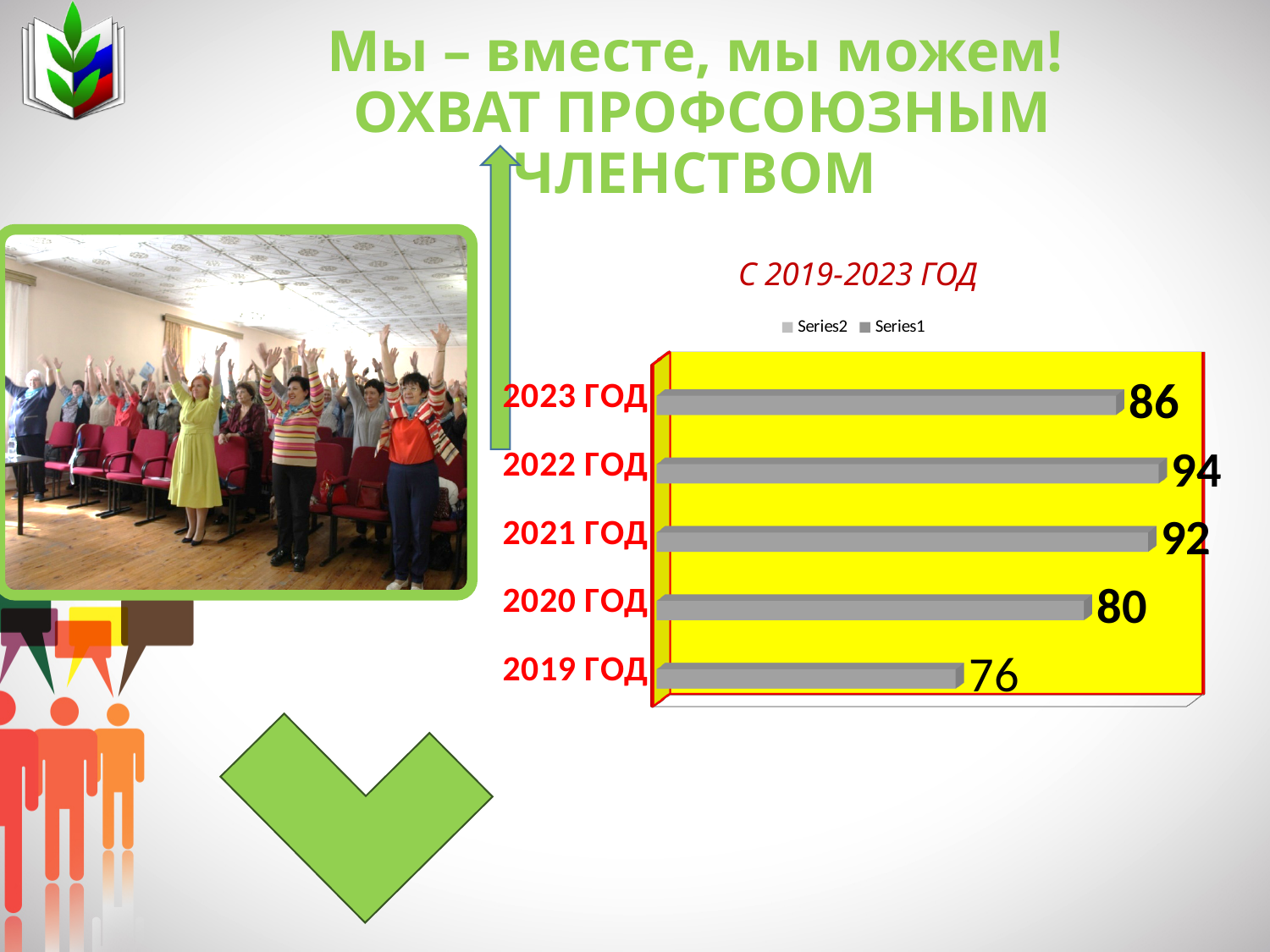
What is the title of the chart? С 2019-2023 ГОД What kind of chart is shown? bar chart Which is larger, the value for 2020 ГОД or the value for 2023 ГОД? 2023 ГОД Which year has the lowest value? 2019 ГОД How many years are shown in the chart? 5 What is the difference between the values for 2022 ГОД and 2023 ГОД? 8 Which year has the highest value? 2022 ГОД What is the value for 2021 ГОД? 92 What is the difference between the values for 2022 ГОД and 2019 ГОД? 18 How many series does the legend list? 2 What is the value for 2019 ГОД? 76 What is the value for 2023 ГОД? 86